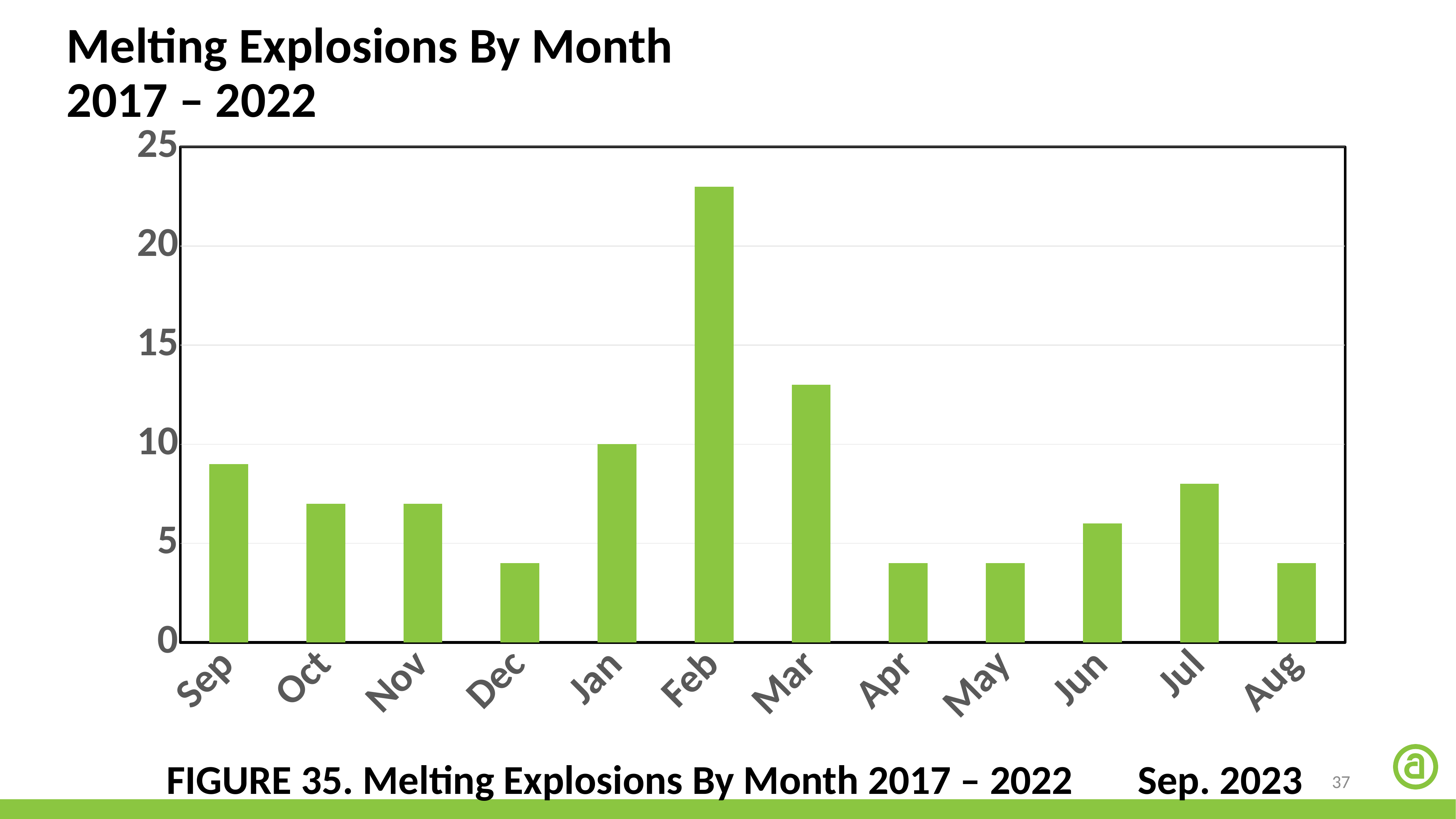
Is the value for Mar greater or less than 15? less What is the title of the chart? Melting Explosions By Month 2017 – 2022 What is the value for Jan? 10 Is the value for Dec greater or less than 5? less What kind of chart is shown on the slide? bar chart Which is larger, the value for Jul or the value for Apr? Jul Which month has the highest number of melting explosions? Feb Is the value for Feb greater or less than 20? greater How many months are shown on the x axis of the chart? 12 Which is larger, the value for Jan or the value for Jun? Jan Which is larger, the value for Feb or the value for Mar? Feb